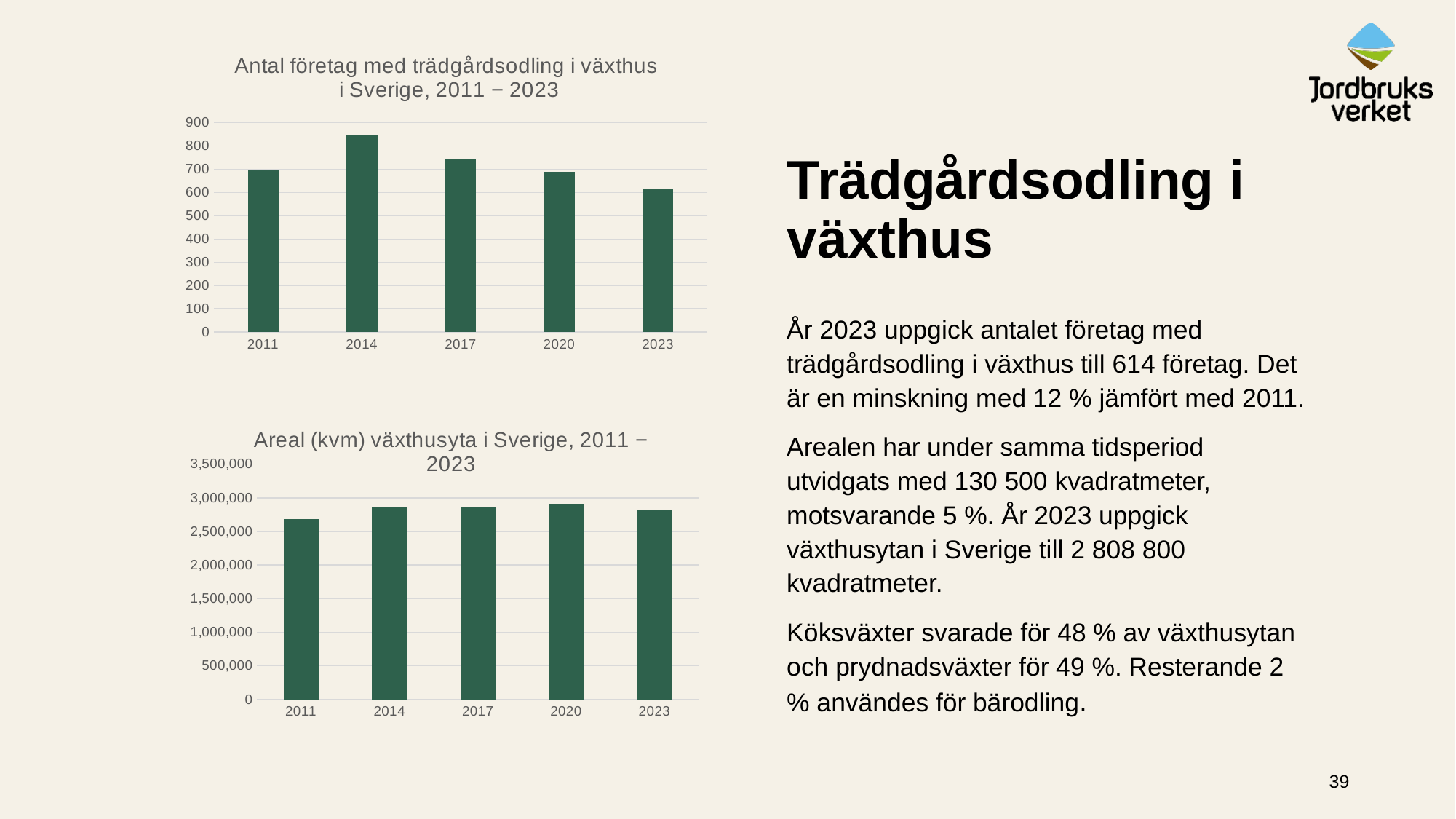
In the top chart, 'Antal företag med trädgårdsodling i växthus', is the value for 2014 greater or less than 800? greater In the top chart, 'Antal företag med trädgårdsodling i växthus', which year has the highest number of companies? 2014 In the bottom chart, 'Areal (kvm) växthusyta i Sverige', which year has the smallest area? 2011 In the top chart, 'Antal företag med trädgårdsodling i växthus', which is larger, the value for 2017 or the value for 2020? 2017 In the bottom chart, 'Areal (kvm) växthusyta i Sverige', is the value for 2020 greater or less than 3,000,000? less How many years are shown on the x axis of the top chart, 'Antal företag med trädgårdsodling i växthus'? 5 What kind of chart is the bottom chart, 'Areal (kvm) växthusyta i Sverige, 2011 − 2023'? bar chart In the top chart, 'Antal företag med trädgårdsodling i växthus', is the value for 2023 greater or less than 700? less How many bars are there in the bottom chart, 'Areal (kvm) växthusyta i Sverige'? 5 In the bottom chart, 'Areal (kvm) växthusyta i Sverige', which is larger, the value for 2011 or the value for 2014? 2014 In the top chart, 'Antal företag med trädgårdsodling i växthus', which year has the lowest number of companies? 2023 What kind of chart is the top chart, 'Antal företag med trädgårdsodling i växthus i Sverige, 2011 − 2023'? bar chart